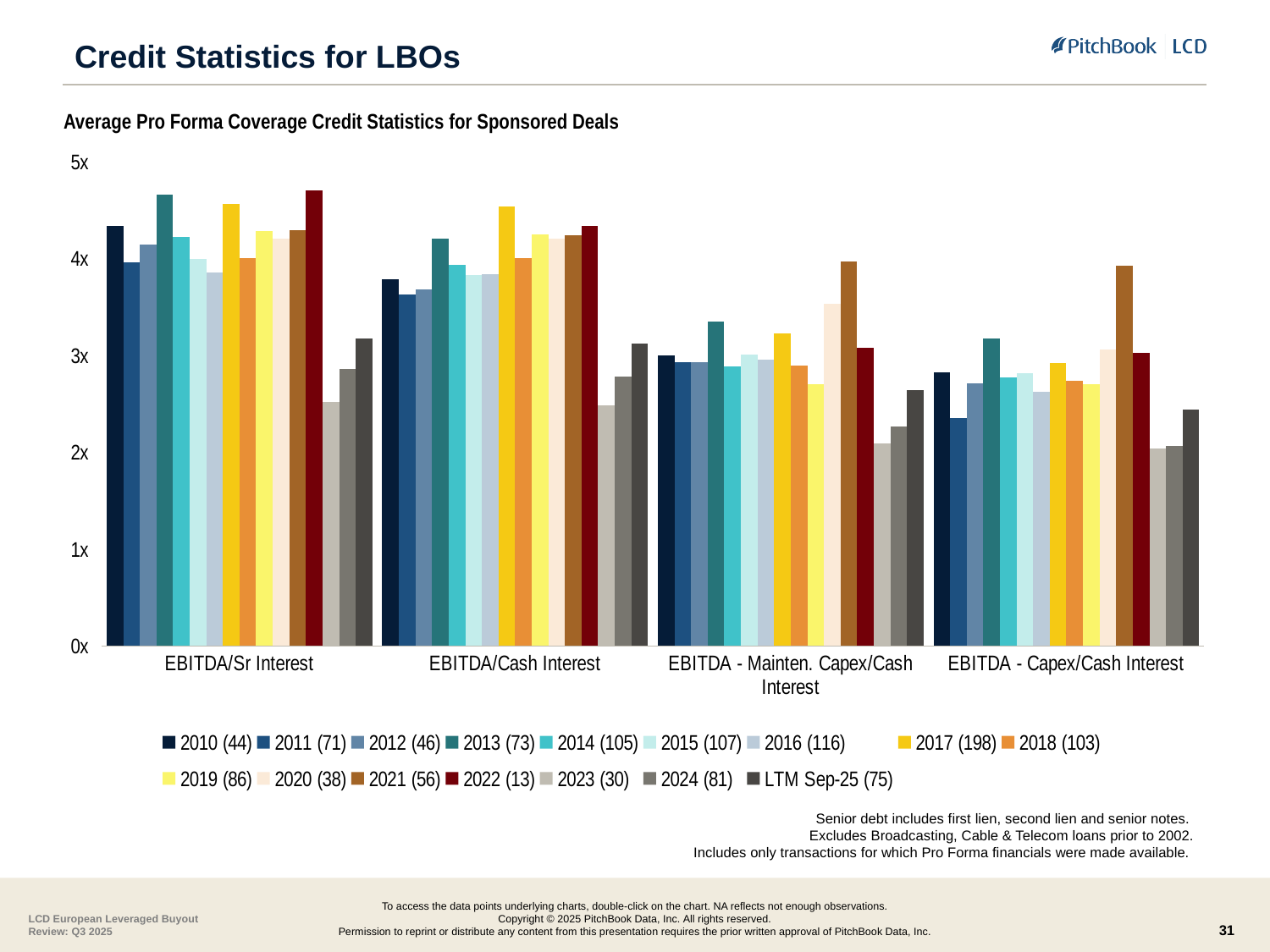
Is the value for 2021 (56) in the EBITDA - Capex/Cash Interest group greater or less than 3x? greater Is the value for 2023 (30) in the EBITDA/Sr Interest group greater or less than 3x? less Is the value for 2022 (13) in the EBITDA/Sr Interest group greater or less than 4x? greater What is the title of the chart? Average Pro Forma Coverage Credit Statistics for Sponsored Deals What kind of chart is shown on the slide? Bar chart Which series has the lowest value in the EBITDA/Sr Interest group? 2023 (30) In the EBITDA/Cash Interest group, which series has the lowest value? 2023 (30) How many series does the legend list? 16 In the EBITDA/Sr Interest group, which is larger: the value for 2017 (198) or the value for 2016 (116)? 2017 (198) How many coverage ratio categories are shown along the x axis? 4 Which series has the highest value in the EBITDA - Capex/Cash Interest group? 2021 (56)